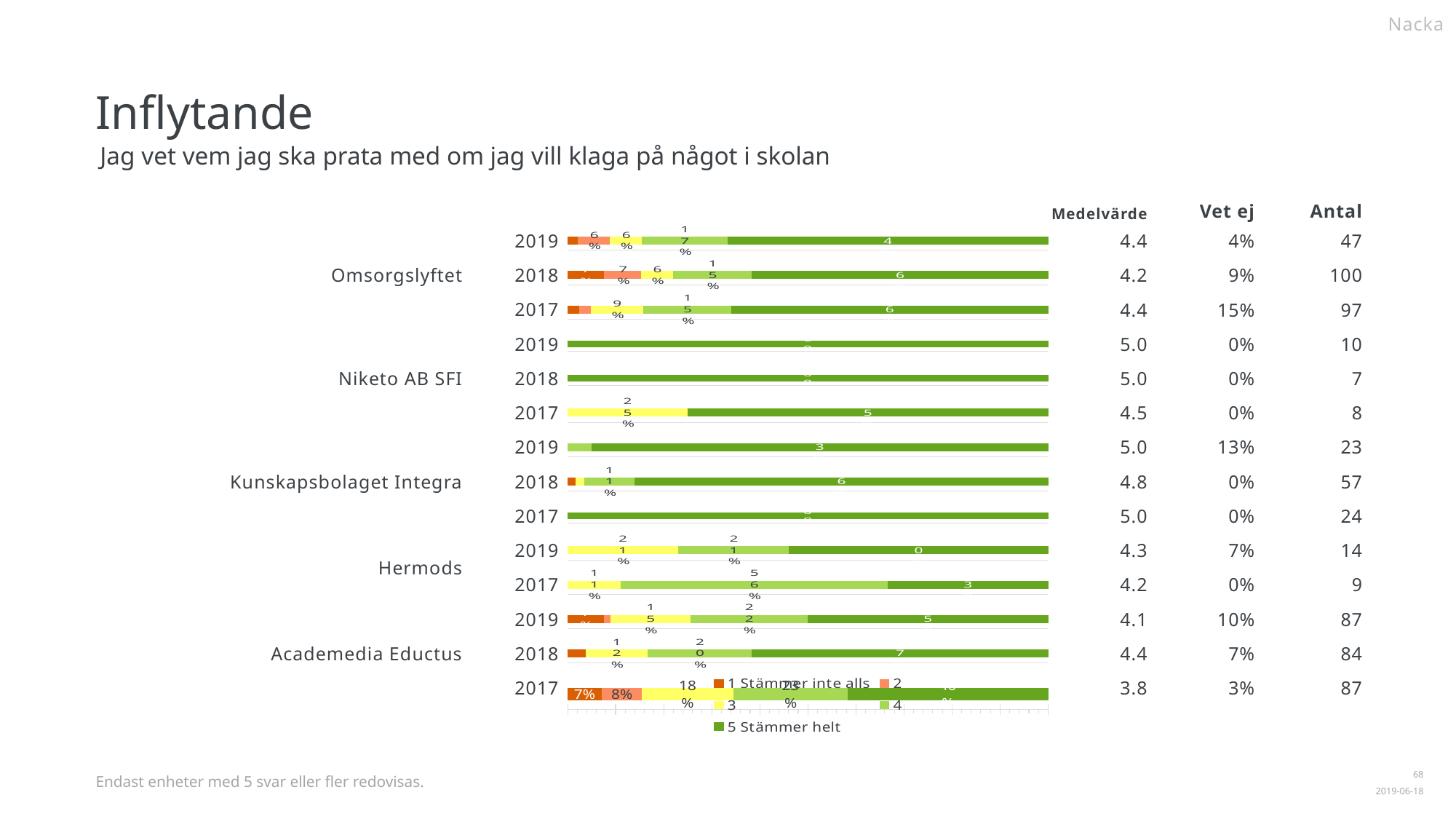
What is the label of the first legend entry in the chart? 1 Stämmer inte alls How many bars (school-year rows) are plotted in the chart? 14 What is the Vet ej value shown for Omsorgslyftet 2017? 15% What is the Medelvärde shown for Academedia Eductus 2017? 3.8 What is the data label for the '1 Stämmer inte alls' segment of the Academedia Eductus 2017 bar? 7% In the Omsorgslyftet 2019 bar, which segment is the largest? 5 Stämmer helt How many series does the chart legend list? 5 What is the Antal shown for Omsorgslyftet 2018? 100 What kind of chart is shown on the slide? Stacked bar chart In the Academedia Eductus 2017 bar, which is larger: the '1 Stämmer inte alls' segment or the '2' segment? 2 What is the label of the last legend entry in the chart? 5 Stämmer helt What is the data label for the '2' segment of the Academedia Eductus 2017 bar? 8%